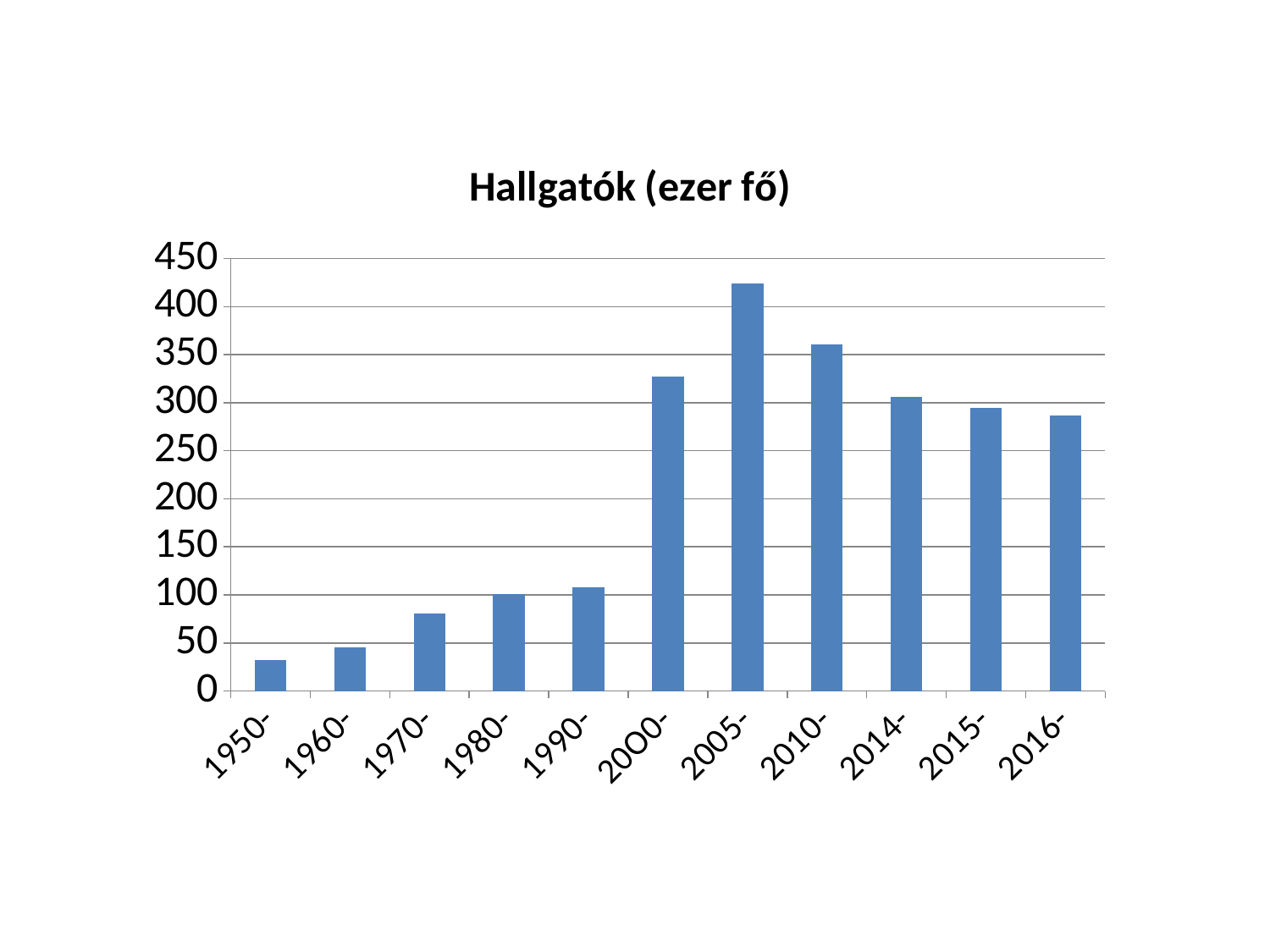
Which is larger, the value for 1950- or the value for 1960-? 1960- Is the value for 2005- greater or less than 400? greater Which category has the lowest value? 1950- Which category has the highest value? 2005- Do the values rise or fall from 2005- to 2016-? fall Is the value for 1950- greater or less than 50? less What kind of chart is shown on the slide? bar chart How many categories are shown on the x axis? 11 Which is larger, the value for 2005- or the value for 2010-? 2005- Is the value for 2016- greater or less than 300? less What is the title of the chart? Hallgatók (ezer fő)